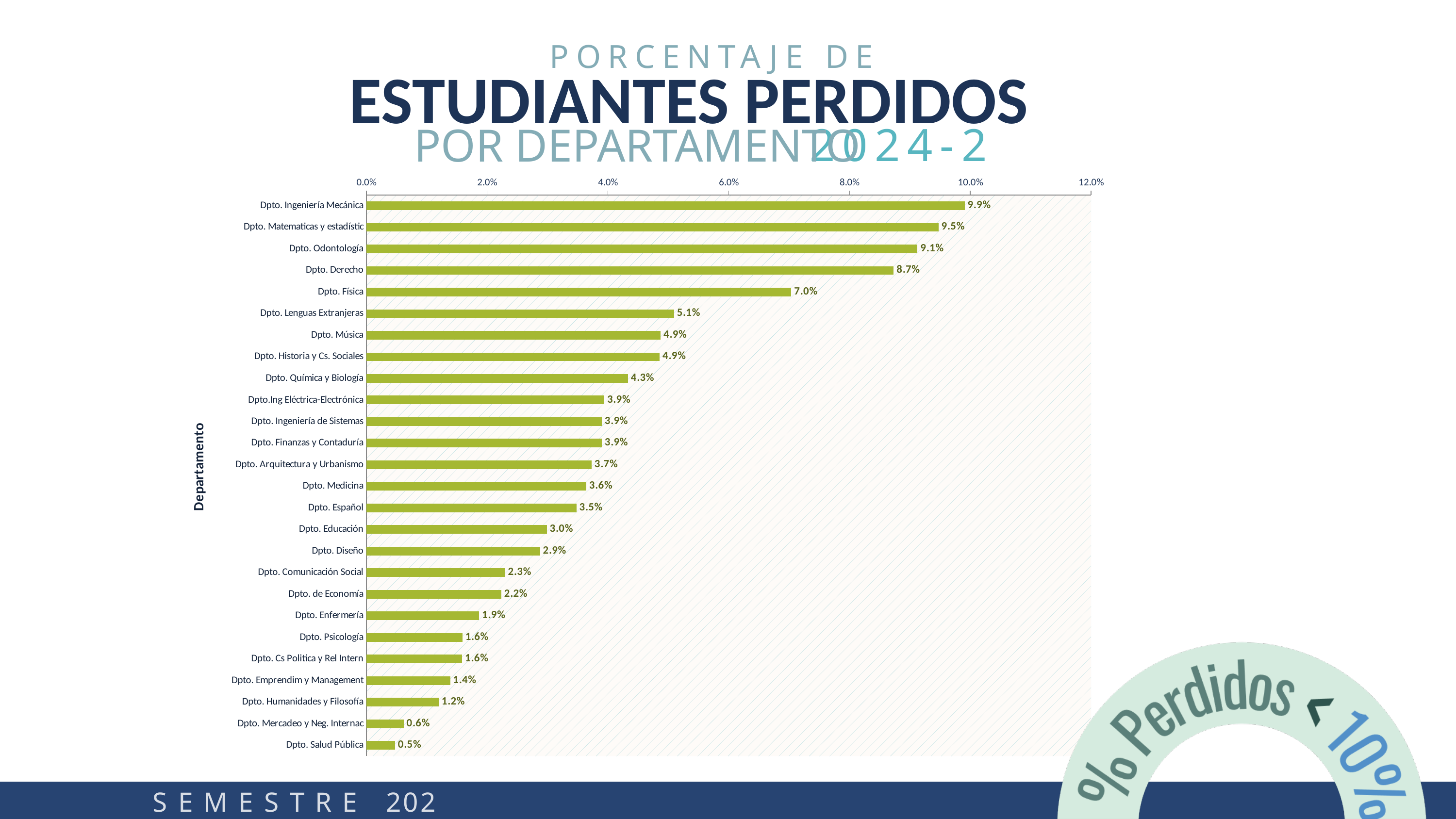
What is the value for Dpto. Medicina? 3.6% Which is larger, the value for Dpto. Odontología or the value for Dpto. Química y Biología? Dpto. Odontología What is the label of the vertical axis? Departamento How many departments are shown in the chart? 26 What is the highest tick value shown on the horizontal axis? 12.0% Which department has the highest percentage of lost students? Dpto. Ingeniería Mecánica Is the value for Dpto. Matematicas y estadístic greater or less than 8.0%? greater What is the value for Dpto. Derecho? 8.7% What kind of chart is shown on the slide? bar chart What is the value for Dpto. Enfermería? 1.9% Which department has the lowest percentage of lost students? Dpto. Salud Pública What is the difference between the values for Dpto. Física and Dpto. Lenguas Extranjeras? 1.9%